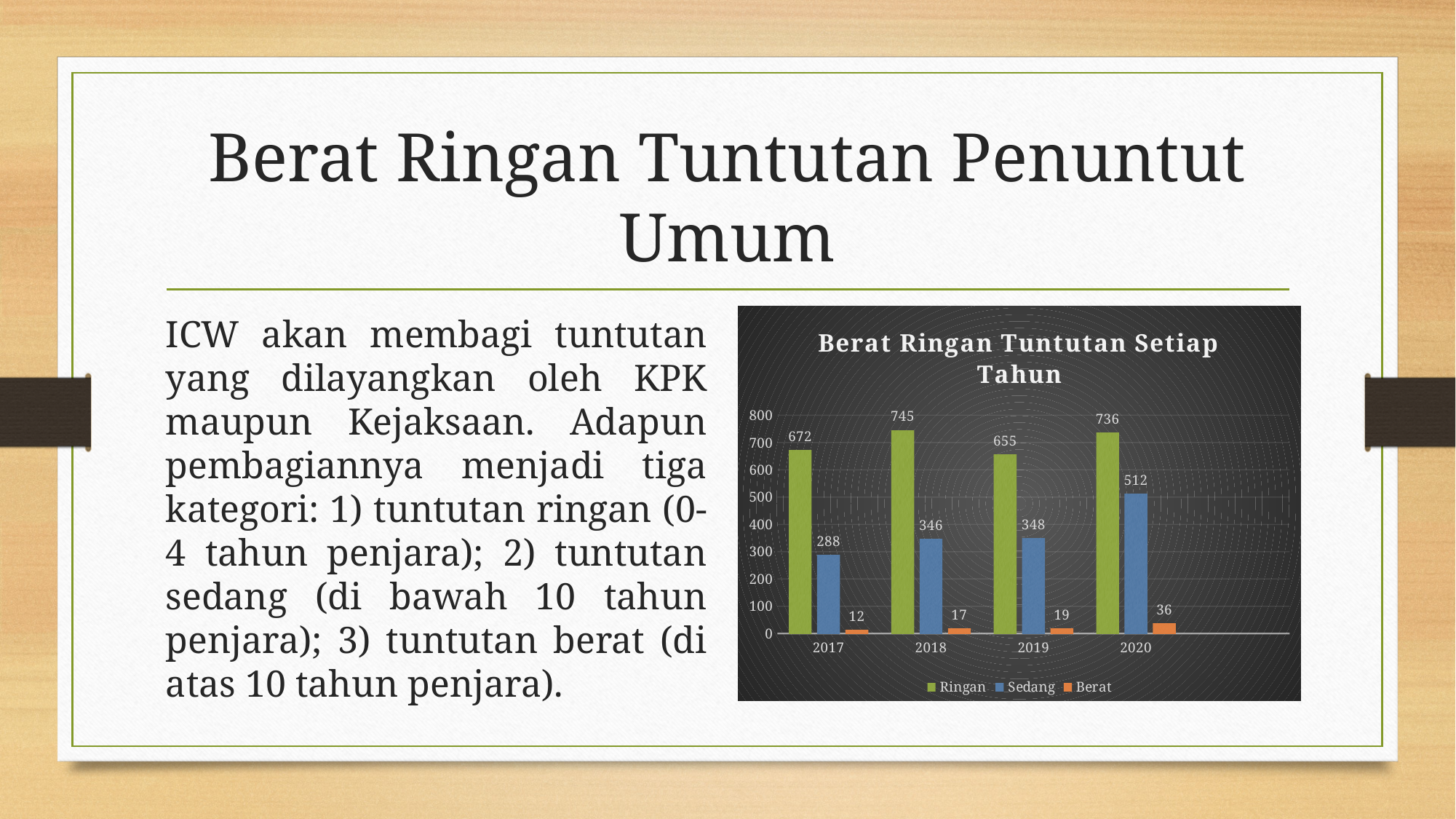
What is the title of the chart? Berat Ringan Tuntutan Setiap Tahun How many years are shown on the x axis? 4 In which year is the Ringan value highest? 2018 What kind of chart is shown on the slide? Bar chart What is the difference between the Ringan values for 2018 and 2019? 90 What is the value for Berat in 2017? 12 Which is larger, the Berat value for 2019 or for 2020? 2020 What is the value for Ringan in 2018? 745 How many series does the legend list? 3 In which year is the Sedang value lowest? 2017 What is the value for Sedang in 2020? 512 Do the Berat values rise or fall from 2017 to 2020? Rise